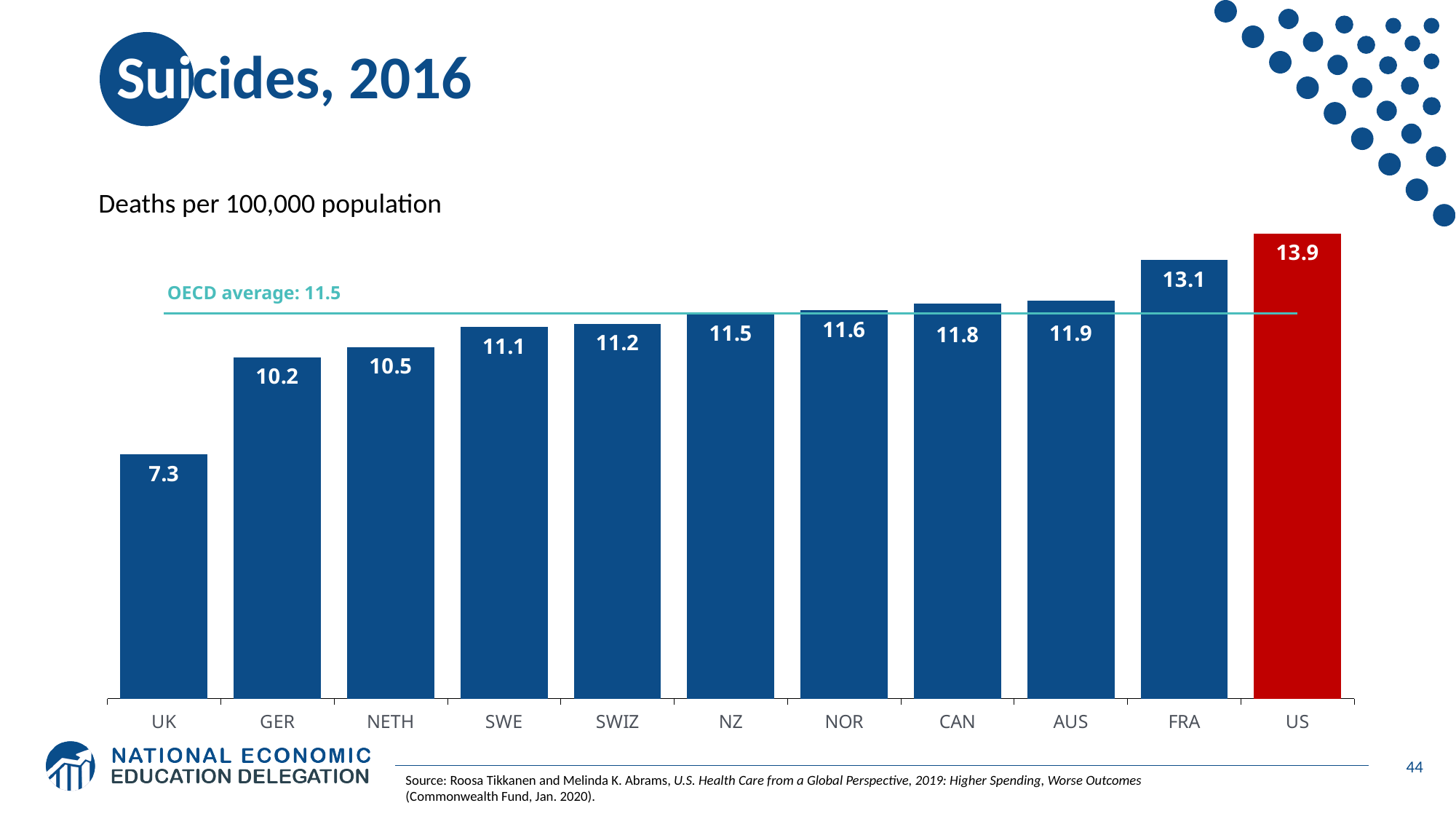
What OECD average value is marked by the horizontal line on the chart? 11.5 How many countries are shown on the chart? 11 Which has a higher value, NETH or SWE? SWE Which country has the lowest suicide rate on the chart? UK Which country has the highest suicide rate on the chart? US What is the suicide rate (deaths per 100,000 population) for the US? 13.9 What is the difference between the US value and the FRA value? 0.8 What is the difference between the UK value and the GER value? 2.9 Do the values rise or fall moving from left to right across the chart? Rise What kind of chart is shown on the slide? Bar chart What is the value shown for GER? 10.2 What is the value shown for NOR? 11.6